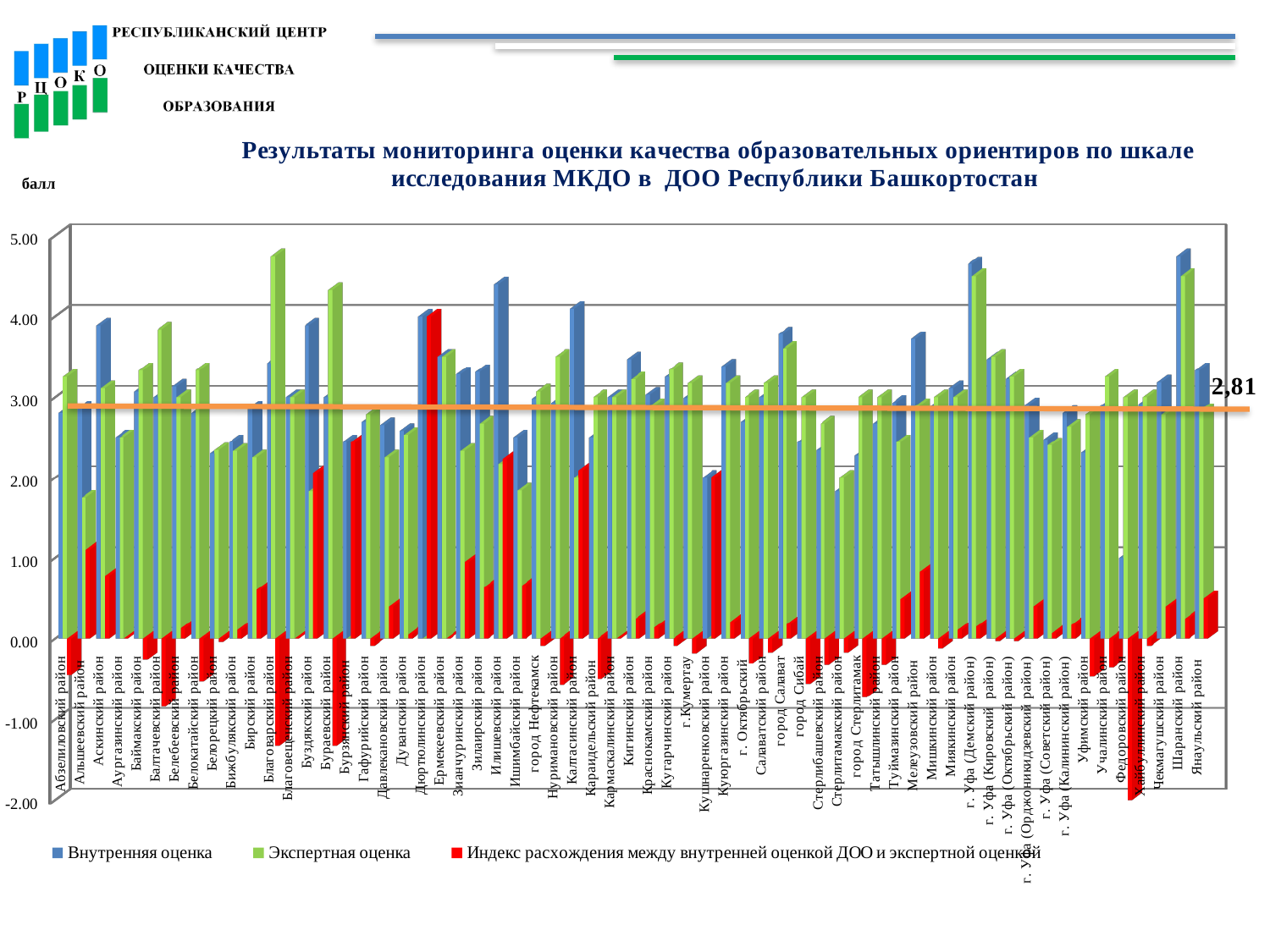
Is the Внутренняя оценка value for Илишевский район greater or less than 4.00? greater What is the label on the vertical axis of the chart? балл Which series is shown in red according to the legend? Индекс расхождения между внутренней оценкой ДОО и экспертной оценкой How many series does the legend list? 3 Is the Экспертная оценка value for Благоварский район greater or less than 4.00? greater Which category has the lowest Индекс расхождения (red bar)? Федоровский район What value is labelled on the horizontal orange line across the chart? 2,81 Is the Индекс расхождения value for Федоровский район greater or less than -1.00? less What kind of chart is shown on the slide? bar chart Which category has the highest Индекс расхождения (red bar)? Дюртюлинский район